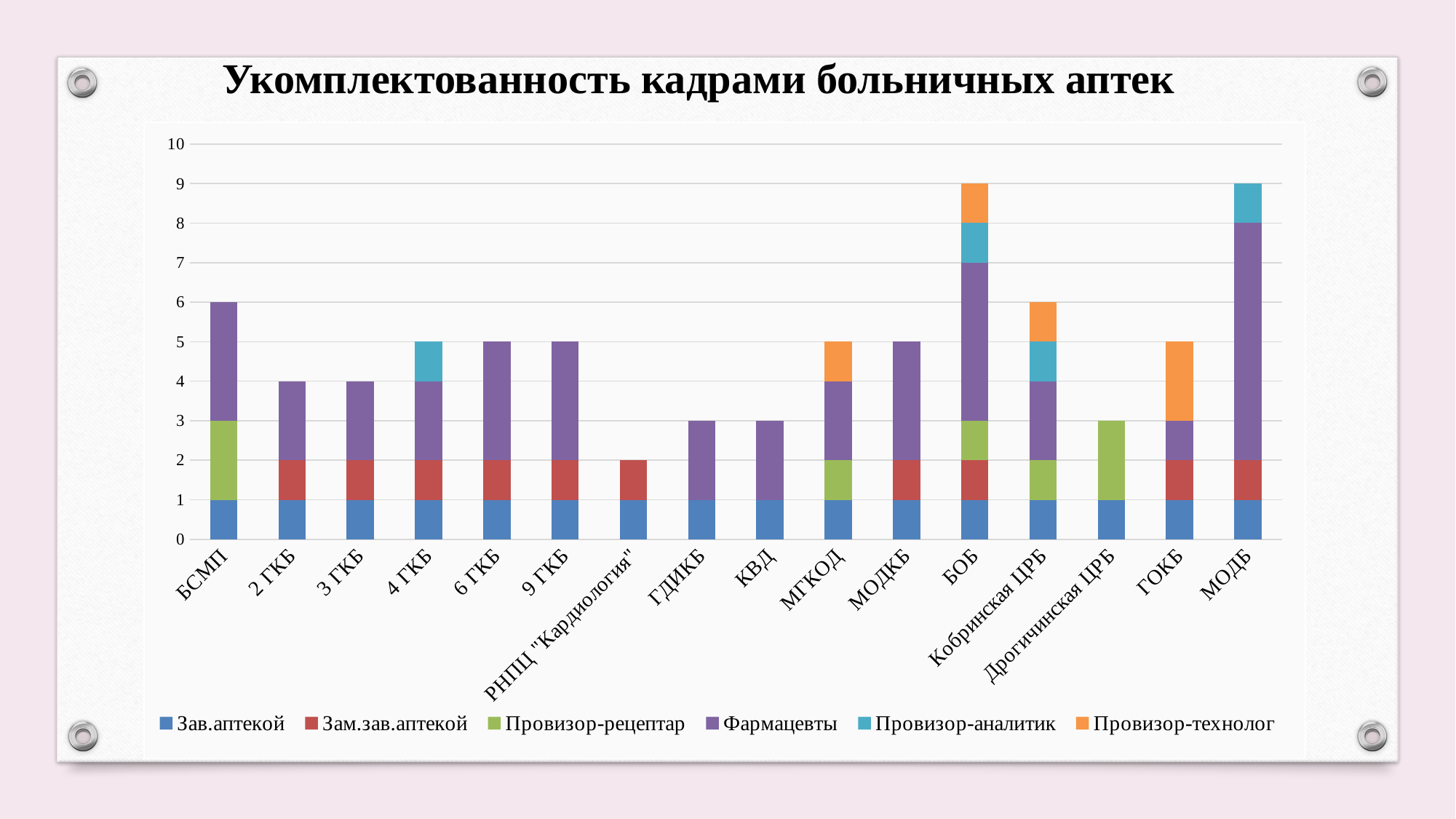
What kind of chart is shown on the slide? stacked bar chart Which category has the lowest total stacked bar? РНПЦ "Кардиология" What is the difference between the total bar for Кобринская ЦРБ and the total bar for Дрогичинская ЦРБ? 3 What is the value of the Провизор-рецептар segment for БСМП? 2 What is the total height of the stacked bar for БСМП? 6 How many series does the legend list? 6 What is the title of the chart? Укомплектованность кадрами больничных аптек How many categories (pharmacies) are shown on the x axis? 16 What is the value of the Фармацевты segment for МОДБ? 6 What is the total height of the stacked bar for БОБ? 9 Which has a larger total bar, МОДБ or ГОКБ? МОДБ Is the total bar for 2 ГКБ greater or less than 5? less